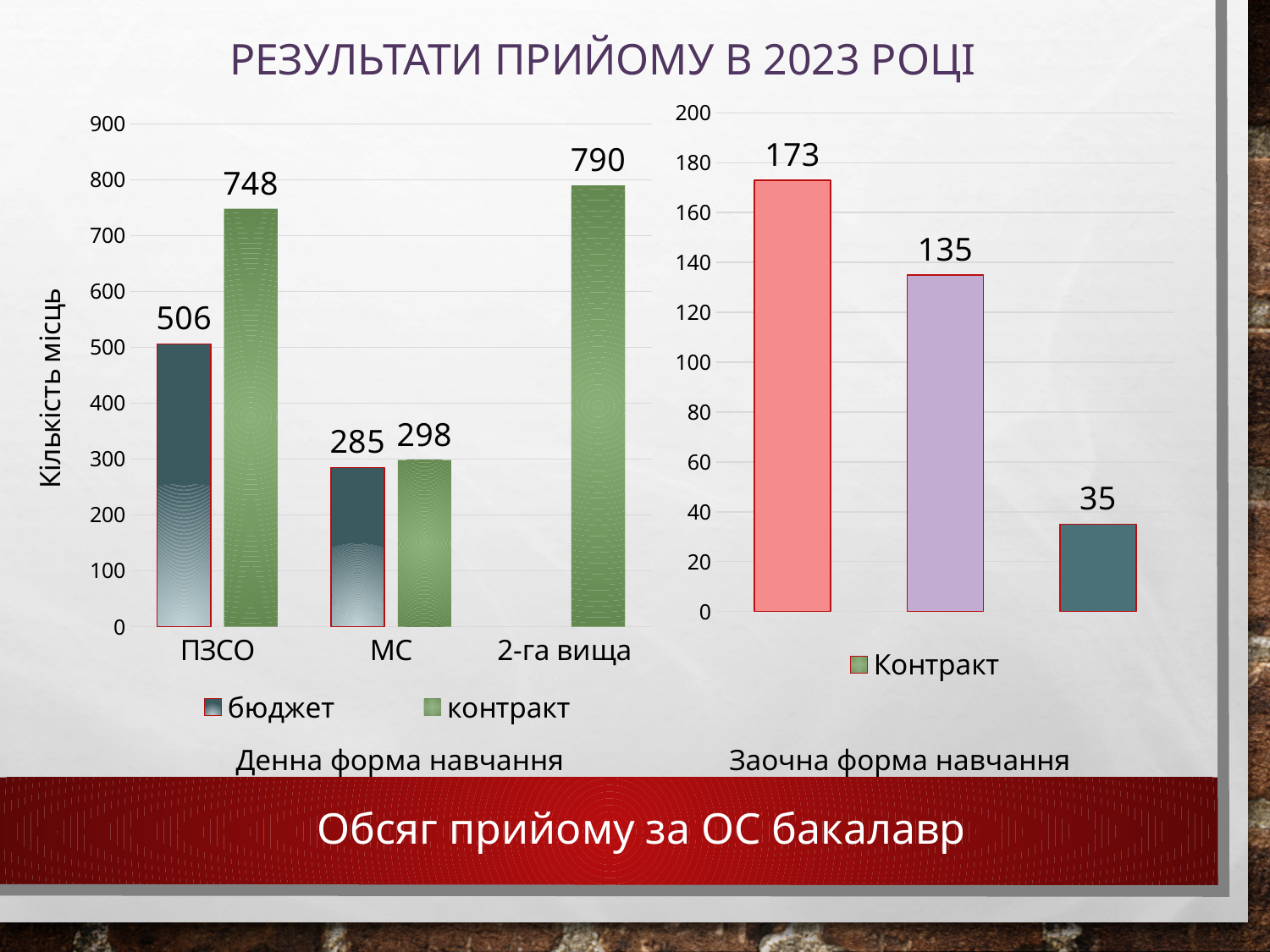
In the left chart (Денна форма навчання), how many categories are shown on the x axis? 3 In the left chart (Денна форма навчання), what is the value of контракт for МС? 298 In the left chart (Денна форма навчання), which is larger for МС: бюджет or контракт? контракт In the left chart (Денна форма навчання), what is the value of бюджет for ПЗСО? 506 In the right chart (Заочна форма навчання), what is the value of the smallest bar? 35 What kind of chart is the right chart (Заочна форма навчання)? bar chart In the left chart (Денна форма навчання), which category has the highest контракт value? 2-га вища In the left chart (Денна форма навчання), what is the value of контракт for 2-га вища? 790 In the left chart (Денна форма навчання), what is the difference between контракт and бюджет for ПЗСО? 242 In the right chart (Заочна форма навчання), what is the value of the tallest bar? 173 In the right chart (Заочна форма навчання), what is the difference between the first bar (173) and the second bar (135)? 38 In the left chart (Денна форма навчання), how many series does the legend list? 2